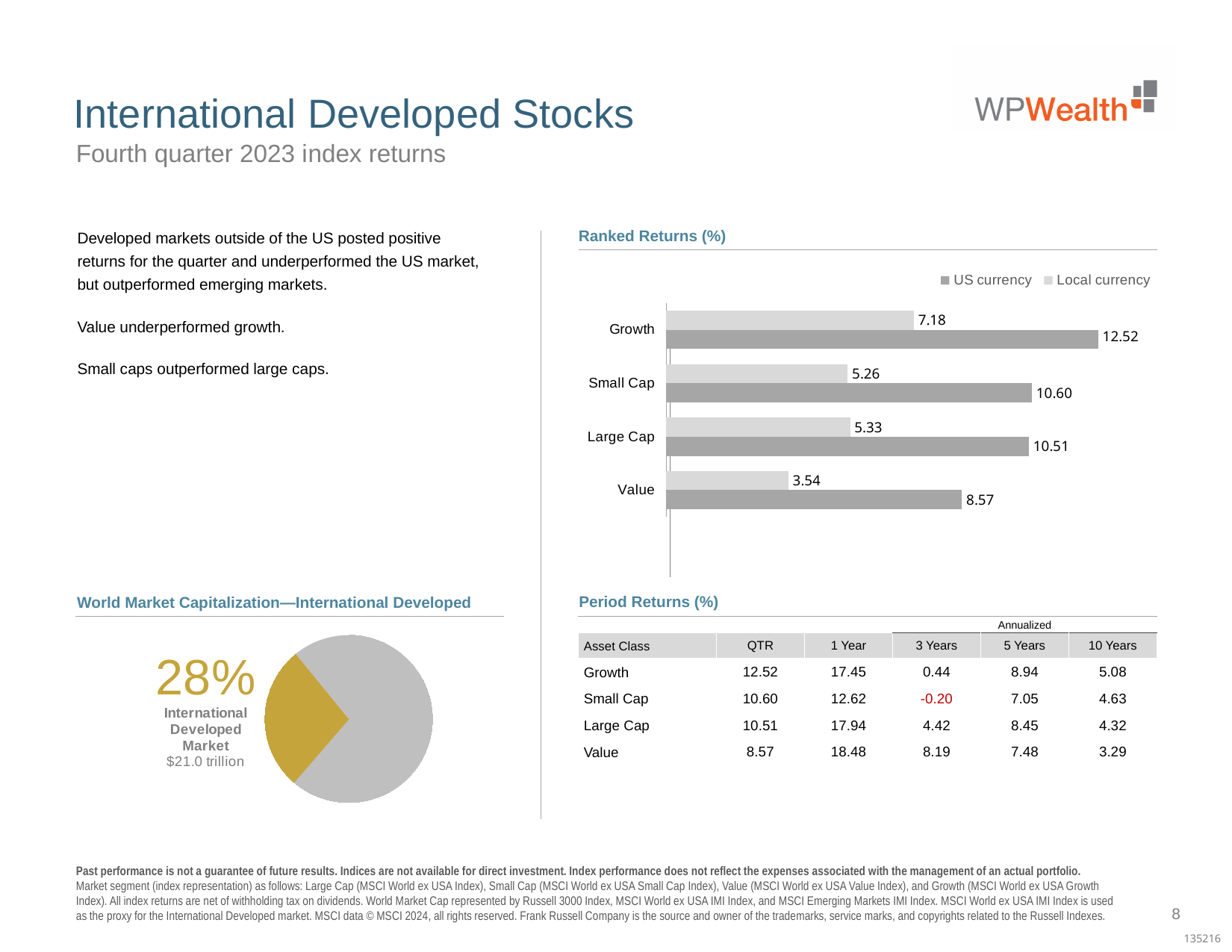
In the Ranked Returns (%) chart, which category has the highest US currency return? Growth How many categories are shown in the Ranked Returns (%) chart? 4 In the Ranked Returns (%) chart, which is larger: the US currency return for Small Cap or the US currency return for Value? Small Cap In the Ranked Returns (%) chart, what is the US currency return for Growth? 12.52 How many series does the legend of the Ranked Returns (%) chart list? 2 What kind of chart is the Ranked Returns (%) chart? Bar chart In the Ranked Returns (%) chart, what is the difference between the US currency and Local currency returns for Growth? 5.34 In the World Market Capitalization—International Developed pie chart, what share does the International Developed Market slice represent? 28% In the Ranked Returns (%) chart, which category has the lowest Local currency return? Value In the Ranked Returns (%) chart, what is the Local currency return for Value? 3.54 In the Ranked Returns (%) chart, what is the Local currency return for Large Cap? 5.33 In the Ranked Returns (%) chart, what is the difference between the US currency returns for Small Cap and Value? 2.03